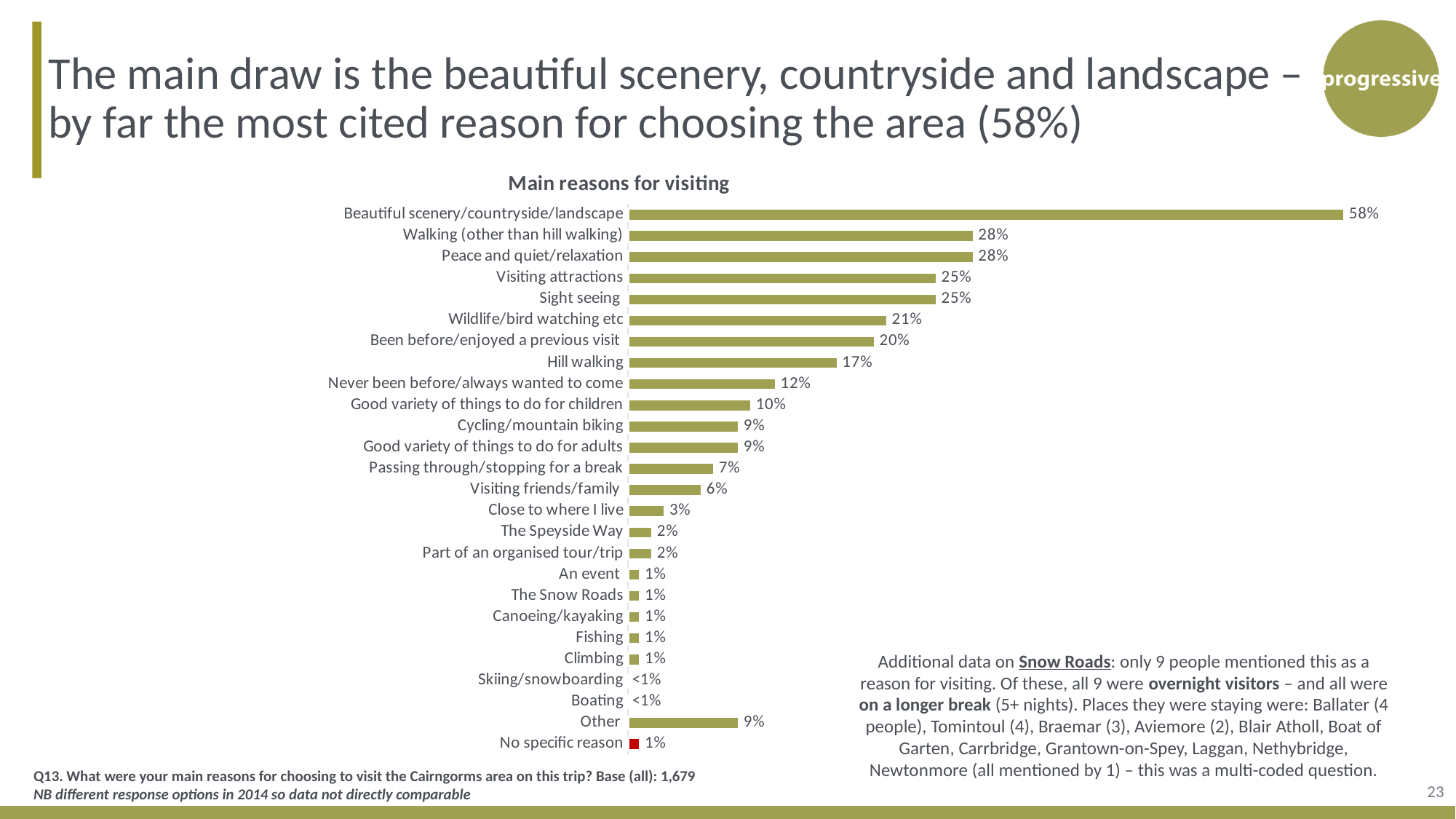
Which is larger, Visiting attractions or Wildlife/bird watching etc? Visiting attractions What kind of chart is shown? Bar chart What is the value for Been before/enjoyed a previous visit? 20% What is the title of the chart? Main reasons for visiting What is the value for Beautiful scenery/countryside/landscape? 58% What is the value for Hill walking? 17% How many reasons are listed in the chart? 26 Which is larger, Close to where I live or Visiting friends/family? Visiting friends/family Which reason has the highest value? Beautiful scenery/countryside/landscape What is the difference between Wildlife/bird watching etc and Never been before/always wanted to come? 9% What is the difference between Beautiful scenery/countryside/landscape and Walking (other than hill walking)? 30% What is the value for Skiing/snowboarding? <1%